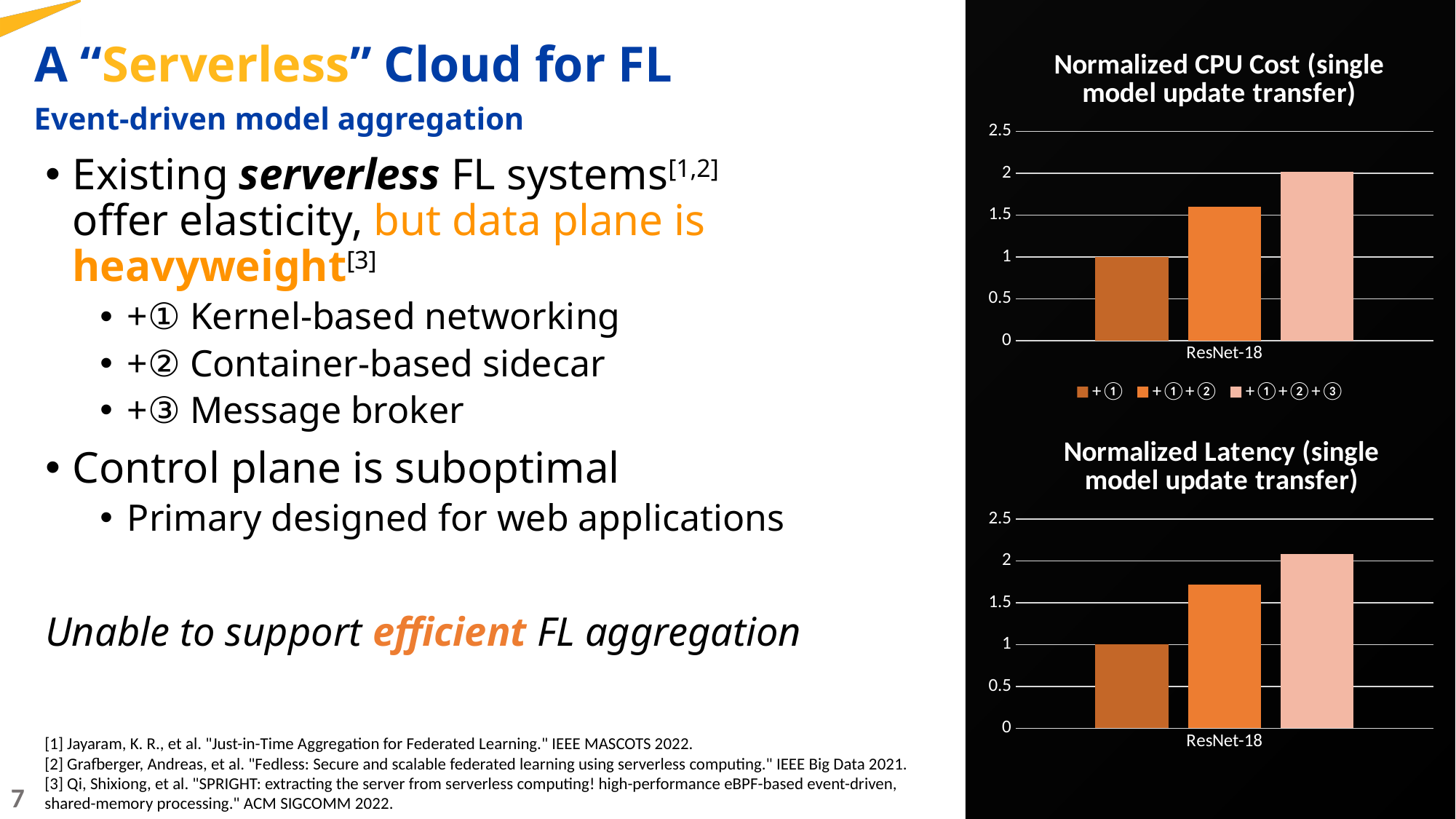
What kind of chart is the Normalized CPU Cost (single model update transfer) chart? bar chart In the Normalized CPU Cost (single model update transfer) chart, is the value for +①+② greater or less than 1.5? greater In the Normalized Latency (single model update transfer) chart, which is larger for ResNet-18: +①+② or +①+②+③? +①+②+③ In the Normalized Latency (single model update transfer) chart, is the value for +①+②+③ greater or less than 2? greater In the Normalized Latency (single model update transfer) chart, which series has the lowest value for ResNet-18? +① What is the category label on the x axis of the Normalized CPU Cost (single model update transfer) chart? ResNet-18 How many series does the legend of the Normalized CPU Cost (single model update transfer) chart list? 3 In the Normalized CPU Cost (single model update transfer) chart, which series has the highest value for ResNet-18? +①+②+③ How many categories are shown on the x axis of the Normalized Latency (single model update transfer) chart? 1 In the Normalized Latency (single model update transfer) chart, what is the value of the +① series for ResNet-18? 1 What is the title of the lower chart on the slide? Normalized Latency (single model update transfer) In the Normalized CPU Cost (single model update transfer) chart, what is the value of the +① series for ResNet-18? 1